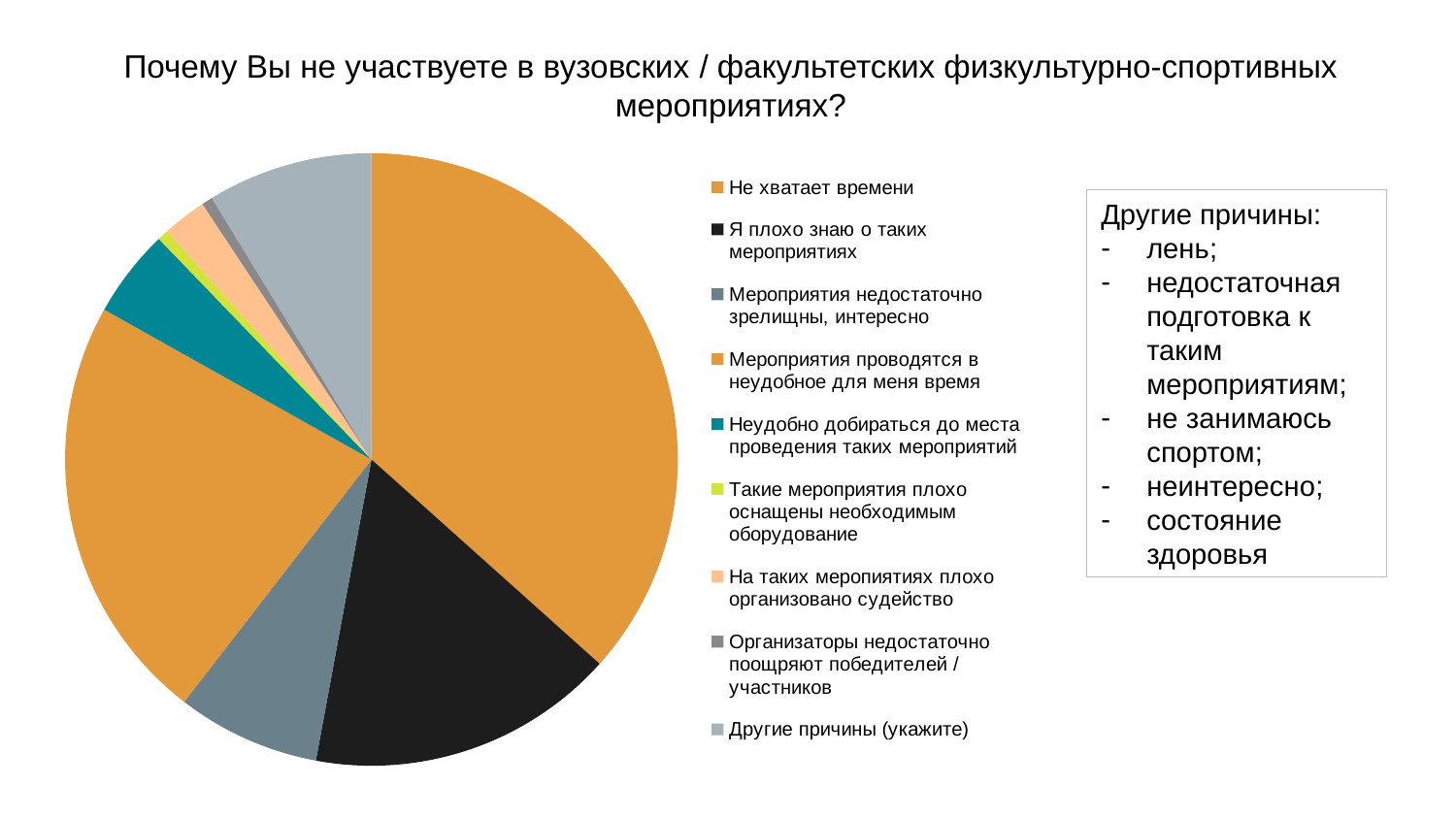
Which slice is larger: "Я плохо знаю о таких мероприятиях" or "На таких меропиятиях плохо организовано судейство"? Я плохо знаю о таких мероприятиях What kind of chart is shown on the slide? pie chart Which category has the largest slice of the pie chart? Не хватает времени Which slice is larger: "Не хватает времени" or "Я плохо знаю о таких мероприятиях"? Не хватает времени Which slice is larger: "Другие причины (укажите)" or "Неудобно добираться до места проведения таких мероприятий"? Другие причины (укажите) What is the title of the chart on the slide? Почему Вы не участвуете в вузовских / факультетских физкультурно-спортивных мероприятиях? What colour is the slice for "Я плохо знаю о таких мероприятиях"? black How many categories (slices) does the pie chart have? 9